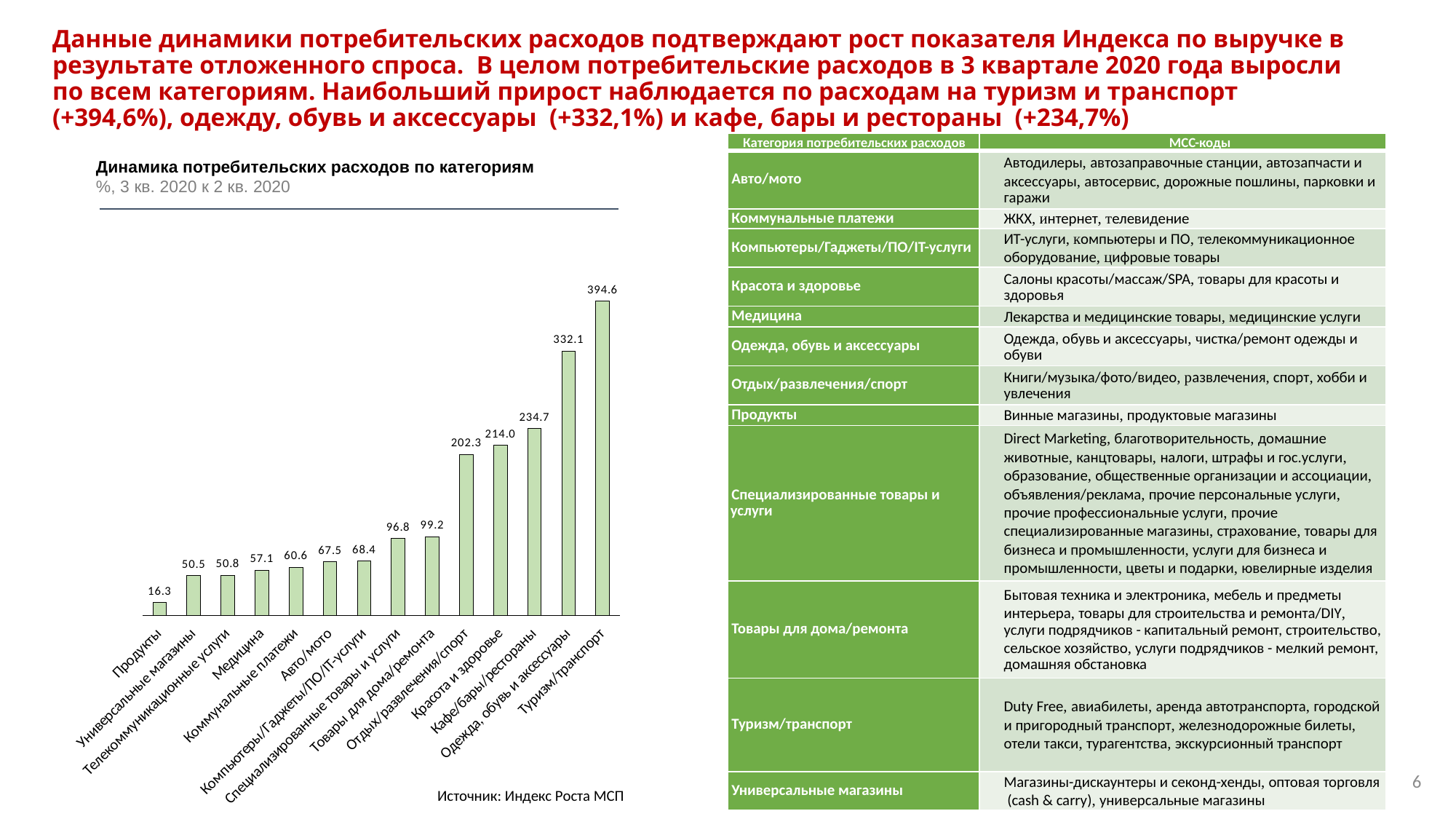
What kind of chart is shown on the slide? Bar chart What is the value for Туризм/транспорт in the chart? 394.6 What is the difference between the values for Красота и здоровье and Отдых/развлечения/спорт? 11.7 What is the value for Продукты in the chart? 16.3 How many categories are shown in the chart? 14 What is the value for Кафе/бары/рестораны in the chart? 234.7 What is the difference between the values for Туризм/транспорт and Одежда, обувь и аксессуары? 62.5 What is the value for Медицина in the chart? 57.1 Which category has the lowest value in the chart? Продукты Do the values rise or fall from left to right along the x axis? Rise Which category has the highest value in the chart? Туризм/транспорт Which is larger: the value for Авто/мото or the value for Товары для дома/ремонта? Товары для дома/ремонта